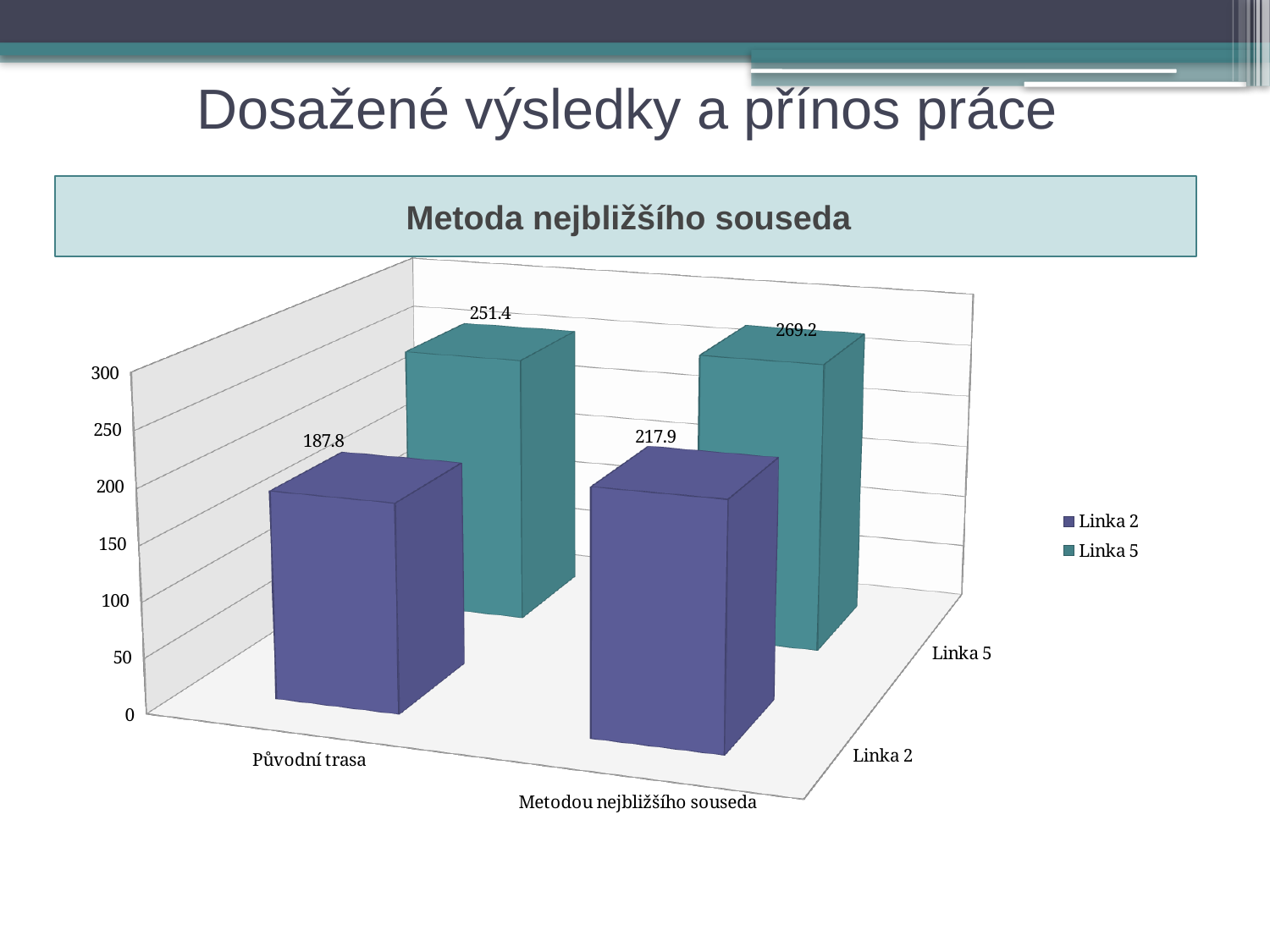
What type of chart is shown on the slide? bar chart Which is larger: Linka 5 for Původní trasa or Linka 2 for Metodou nejbližšího souseda? Linka 5 for Původní trasa How many categories are shown on the x axis? 2 What is the value for Linka 5 in the Metodou nejbližšího souseda category? 269.2 Which series has the highest value in the Metodou nejbližšího souseda category? Linka 5 Do the Linka 5 values rise or fall from Původní trasa to Metodou nejbližšího souseda? rise How many series does the legend list? 2 What is the value for Linka 2 in the Původní trasa category? 187.8 What is the title of the chart? Metoda nejbližšího souseda What is the value for Linka 5 in the Původní trasa category? 251.4 Which category has the lowest value for Linka 2? Původní trasa What is the difference between the Linka 2 values for Metodou nejbližšího souseda and Původní trasa? 30.1